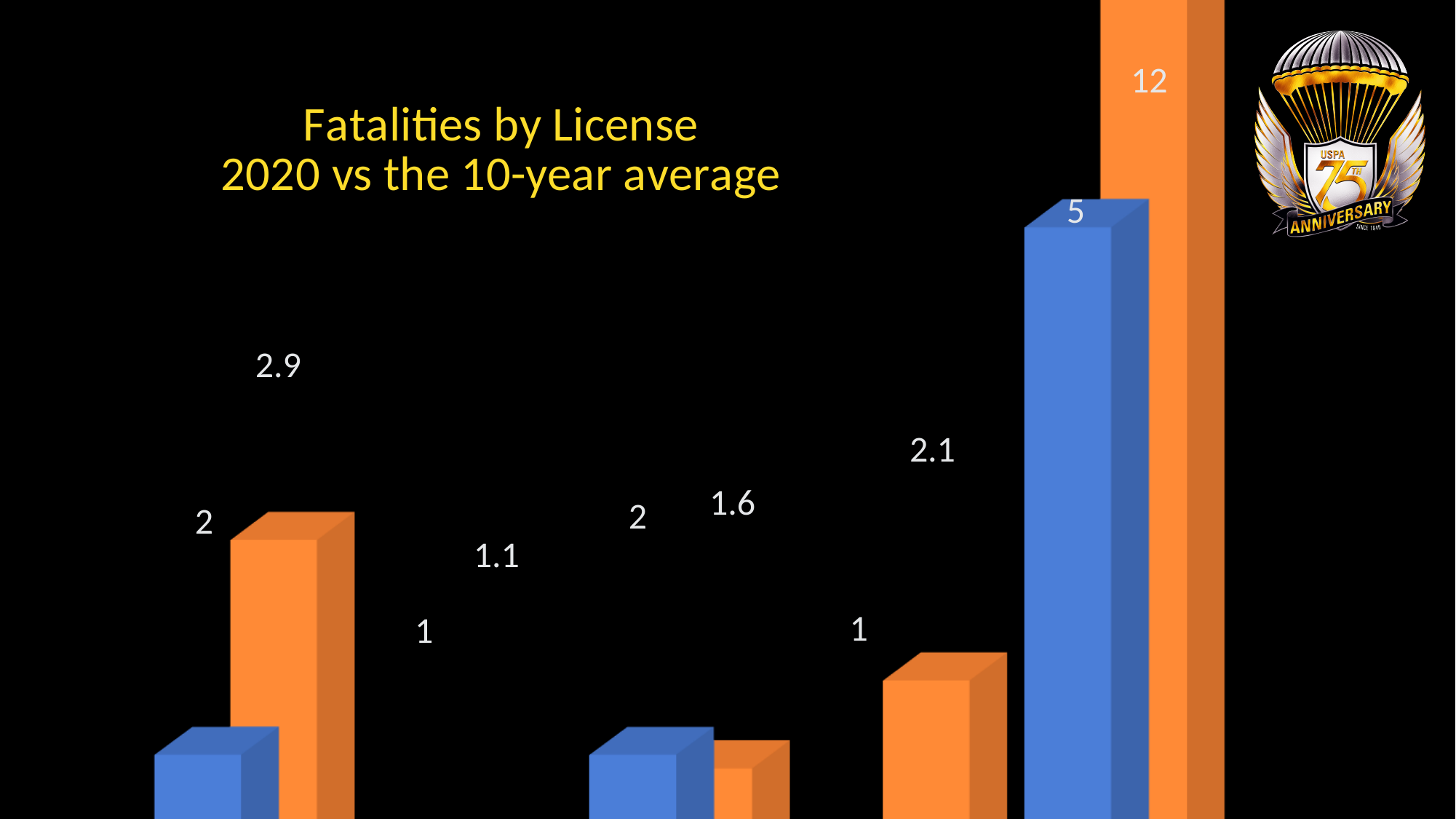
How many bar colours (series) are plotted on the chart? 2 How many groups of bars are shown on the chart? 5 What is the value of the tallest orange bar, in the rightmost group? 12 What is the value of the blue bar in the leftmost group? 2 What is the value of the orange bar in the leftmost group? 2.9 In the rightmost group, which bar is larger, the blue or the orange? orange What is the lowest value labelled on the chart? 1 What is the title of the chart? Fatalities by License 2020 vs the 10-year average What is the value of the blue bar in the rightmost group? 5 What is the highest value labelled on the chart? 12 What kind of chart is shown on the slide? bar chart What is the difference between the orange bar and the blue bar in the rightmost group? 7